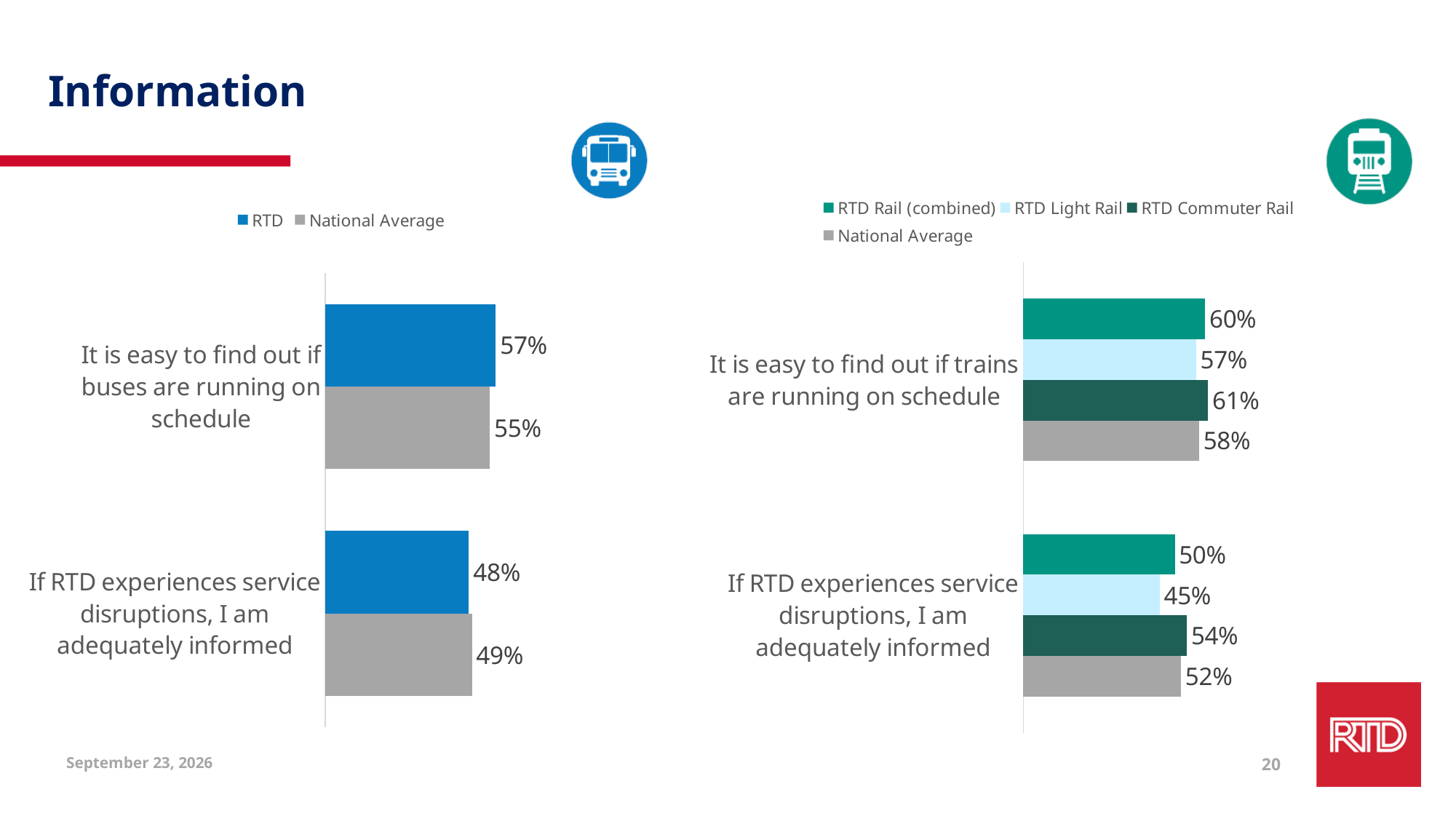
In the right (rail) chart, what is the RTD Commuter Rail value for "It is easy to find out if trains are running on schedule"? 61% How many series does the legend of the left (bus) chart list? 2 In the right (rail) chart, which series has the highest value for "It is easy to find out if trains are running on schedule"? RTD Commuter Rail In the left (bus) chart, what is the National Average value for "If RTD experiences service disruptions, I am adequately informed"? 49% What kind of chart is the right (rail) chart? Bar chart In the left (bus) chart, which is larger for "If RTD experiences service disruptions, I am adequately informed": RTD or National Average? National Average How many series does the legend of the right (rail) chart list? 4 In the left (bus) chart, what is the RTD value for "It is easy to find out if buses are running on schedule"? 57% In the left (bus) chart, what is the difference between the RTD and National Average values for "It is easy to find out if buses are running on schedule"? 2% In the right (rail) chart, what is the RTD Light Rail value for "If RTD experiences service disruptions, I am adequately informed"? 45% In the right (rail) chart, which series has the lowest value for "If RTD experiences service disruptions, I am adequately informed"? RTD Light Rail In the right (rail) chart, what is the difference between the RTD Commuter Rail and RTD Light Rail values for "If RTD experiences service disruptions, I am adequately informed"? 9%